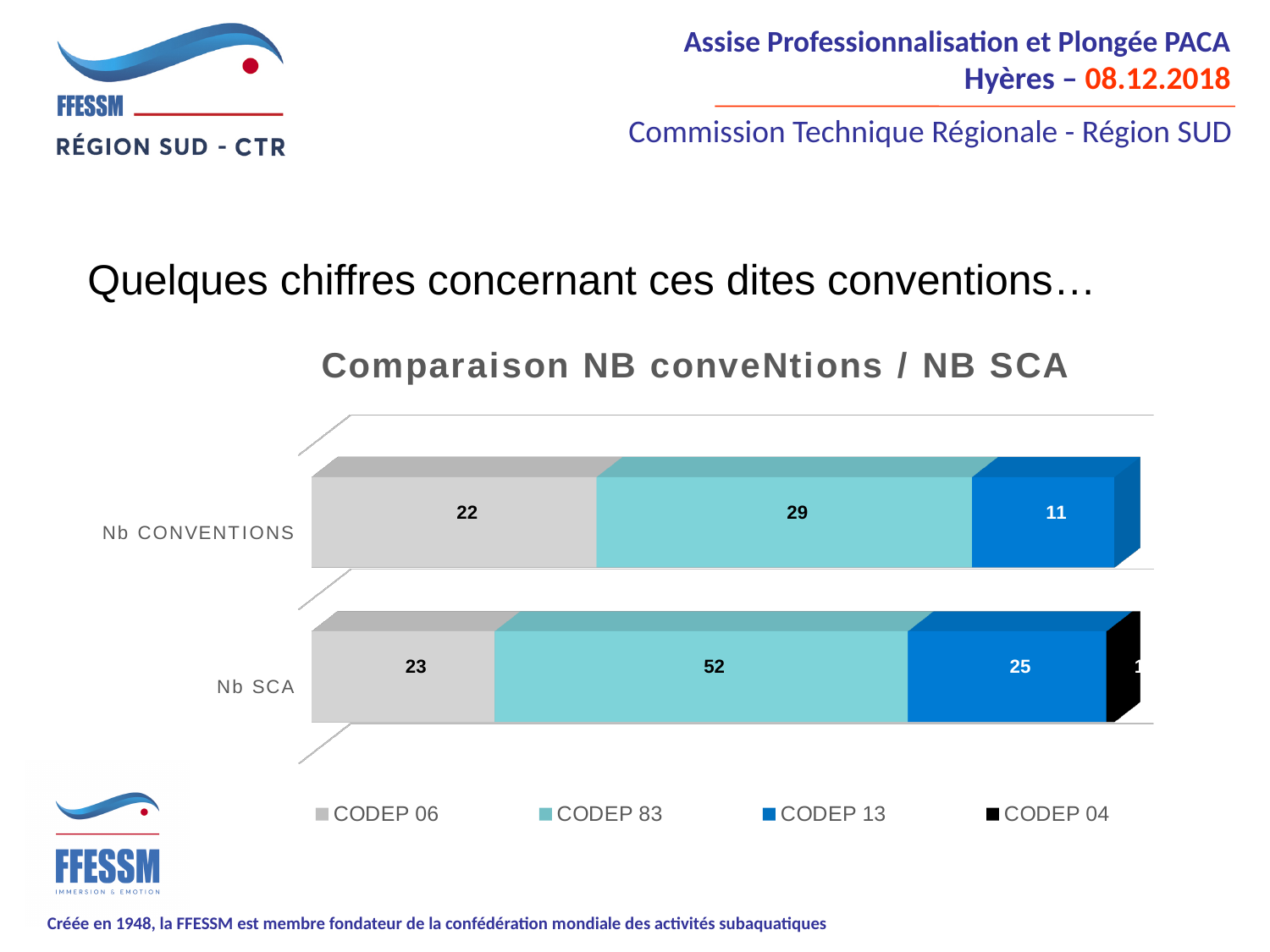
How many series does the legend of the chart list? 4 What is the difference between the CODEP 13 value for Nb SCA and the CODEP 13 value for Nb CONVENTIONS? 14 What is the title of the chart? Comparaison NB conveNtions / NB SCA What is the value for CODEP 13 in the Nb CONVENTIONS bar? 11 How many categories are plotted on the chart? 2 What is the difference between the CODEP 83 value for Nb SCA and the CODEP 83 value for Nb CONVENTIONS? 23 What is the value for CODEP 83 in the Nb SCA bar? 52 What kind of chart is shown on the slide? Stacked bar chart Which CODEP has the largest segment in the Nb SCA bar? CODEP 83 What is the value for CODEP 06 in the Nb CONVENTIONS bar? 22 Which is larger for CODEP 06: the Nb SCA value or the Nb CONVENTIONS value? Nb SCA What is the value for CODEP 13 in the Nb SCA bar? 25